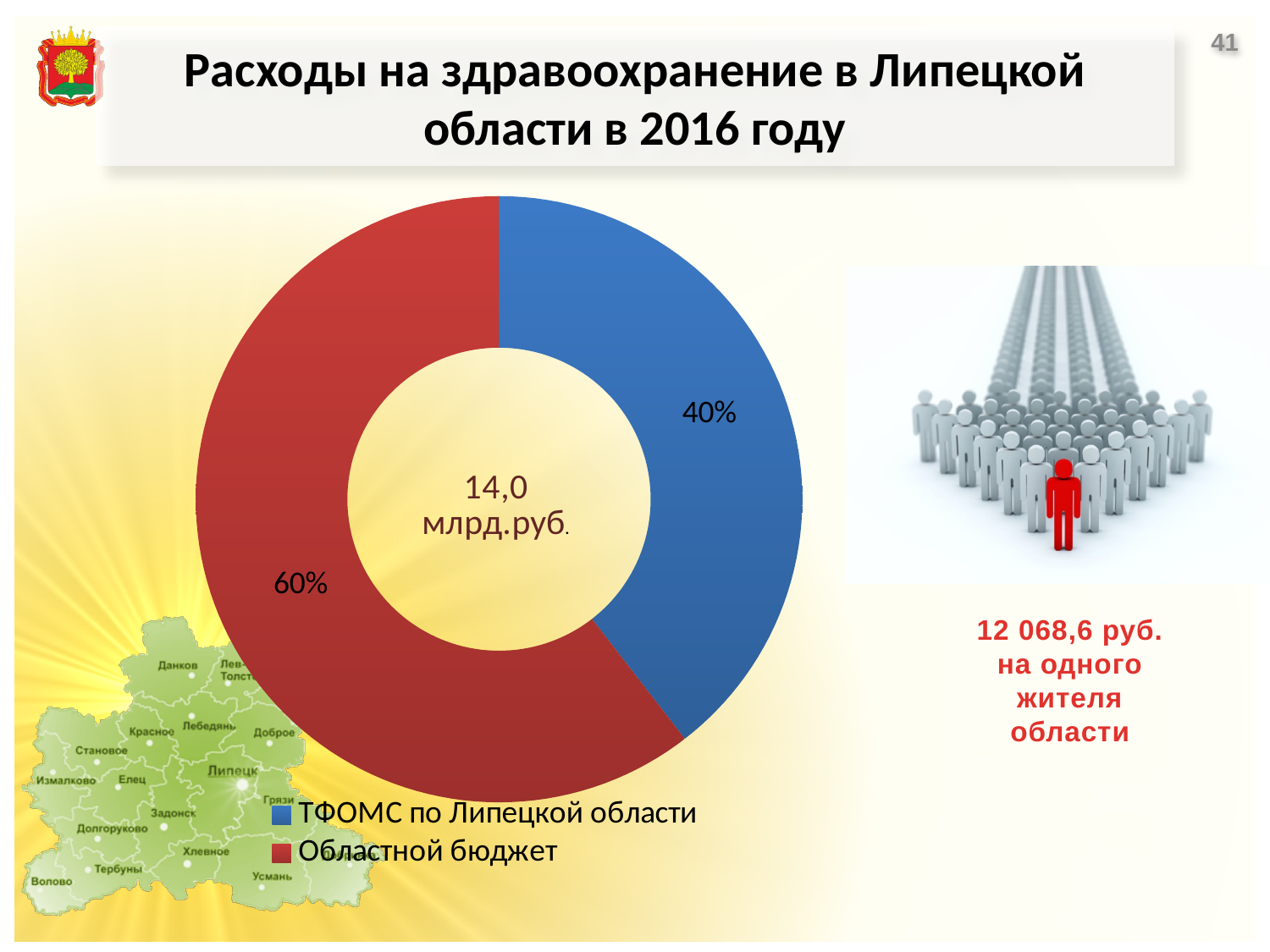
What is the difference in percentage points between the share of Областной бюджет and the share of ТФОМС по Липецкой области? 20 percentage points Which category has the largest share of the chart? Областной бюджет Which is larger: the share of ТФОМС по Липецкой области or the share of Областной бюджет? Областной бюджет Which colour represents Областной бюджет in the chart? Red How many categories does the chart show? 2 Which colour represents ТФОМС по Липецкой области in the chart? Blue What kind of chart is shown on the slide? Doughnut (pie) chart What share of the chart does Областной бюджет account for? 60% What share of the chart does ТФОМС по Липецкой области account for? 40% Which category has the smallest share of the chart? ТФОМС по Липецкой области What total value is printed in the centre of the chart? 14,0 млрд.руб.